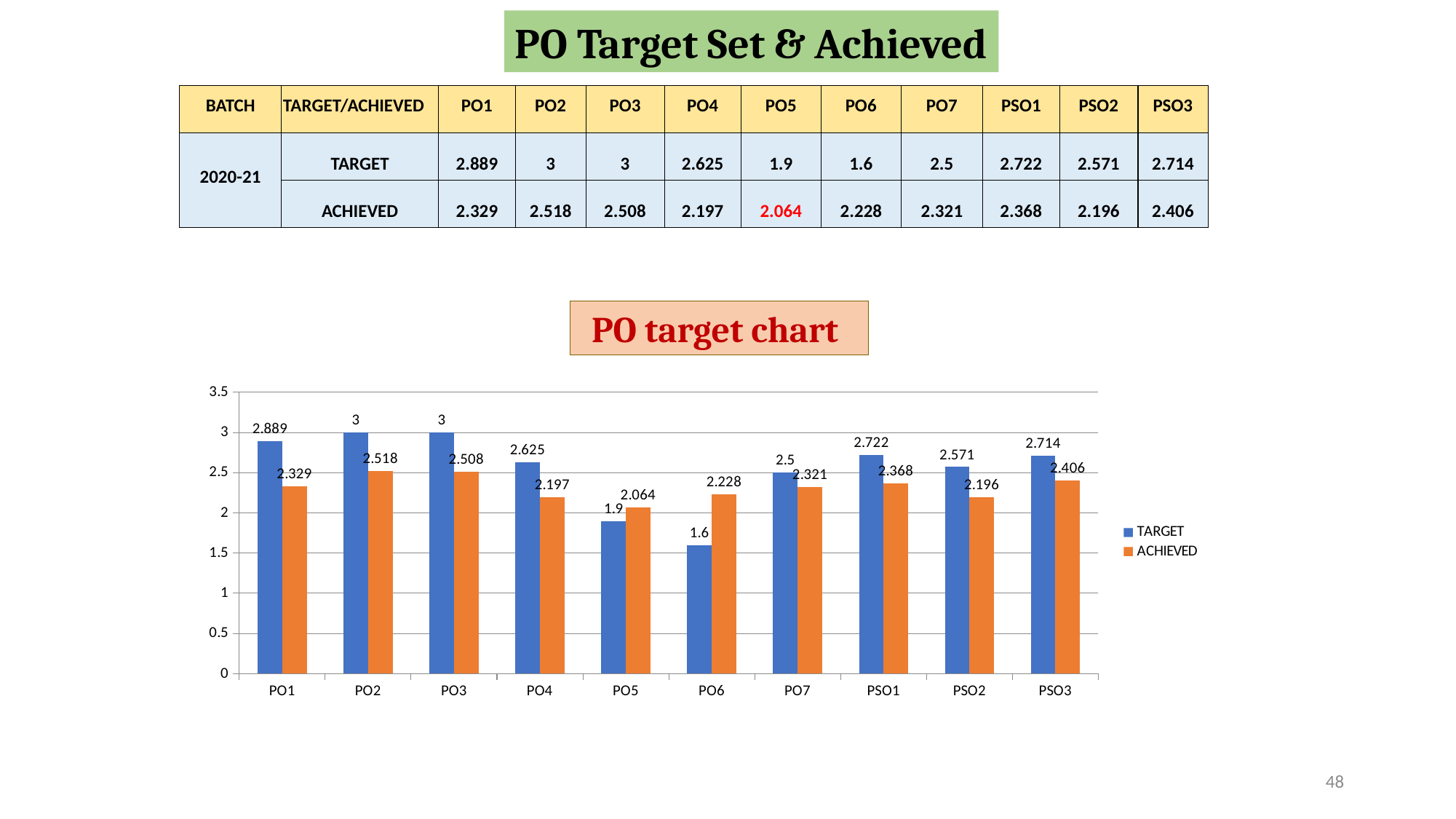
Which colour represents the ACHIEVED series? orange What kind of chart is shown? bar chart Which is larger for PO6, the TARGET or the ACHIEVED value? ACHIEVED How many categories are shown on the x axis? 10 What is the TARGET value for PO4? 2.625 What is the title of the chart? PO target chart What is the ACHIEVED value for PSO3? 2.406 Which category has the highest ACHIEVED value? PO2 What is the difference between the TARGET and ACHIEVED values for PO1? 0.56 Which category has the lowest TARGET value? PO6 Is the ACHIEVED value for PO5 greater or less than 2.5? less How many series does the legend list? 2